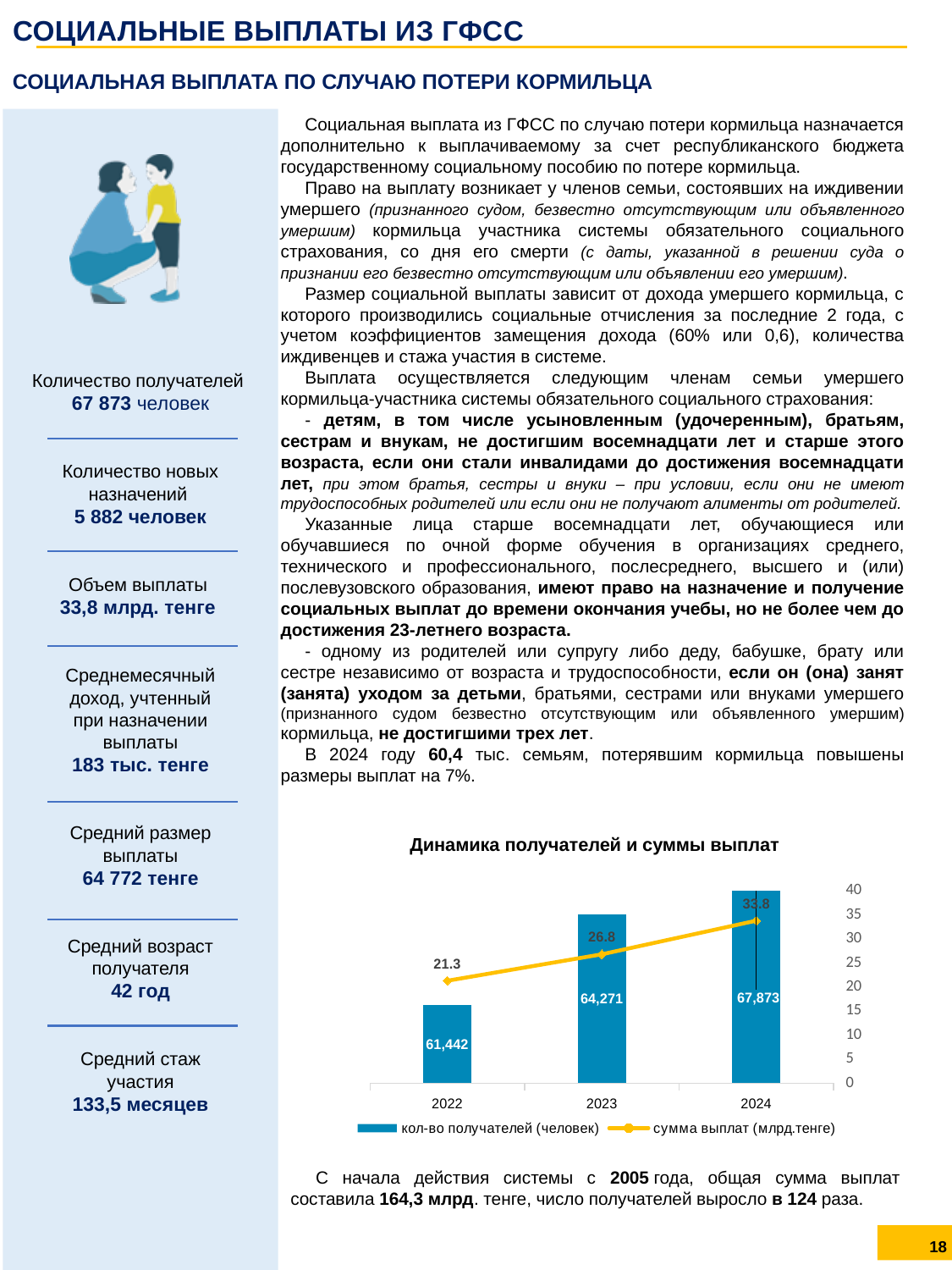
What is the sum of payments (сумма выплат, млрд.тенге) shown for 2022? 21.3 Which year has the highest number of recipients? 2024 How many series does the chart legend list? 2 What is the number of recipients (кол-во получателей) shown for 2022? 61,442 What is the sum of payments (сумма выплат, млрд.тенге) shown for 2023? 26.8 What is the difference in the sum of payments between 2024 and 2023? 7.0 Which year has the lowest sum of payments? 2022 Does the sum of payments rise or fall from 2022 to 2024? rise How many years are shown on the x axis of the chart? 3 Is the number of recipients larger in 2023 or in 2022? 2023 What is the number of recipients (кол-во получателей) shown for 2024? 67,873 By how much did the number of recipients increase from 2022 to 2024? 6,431